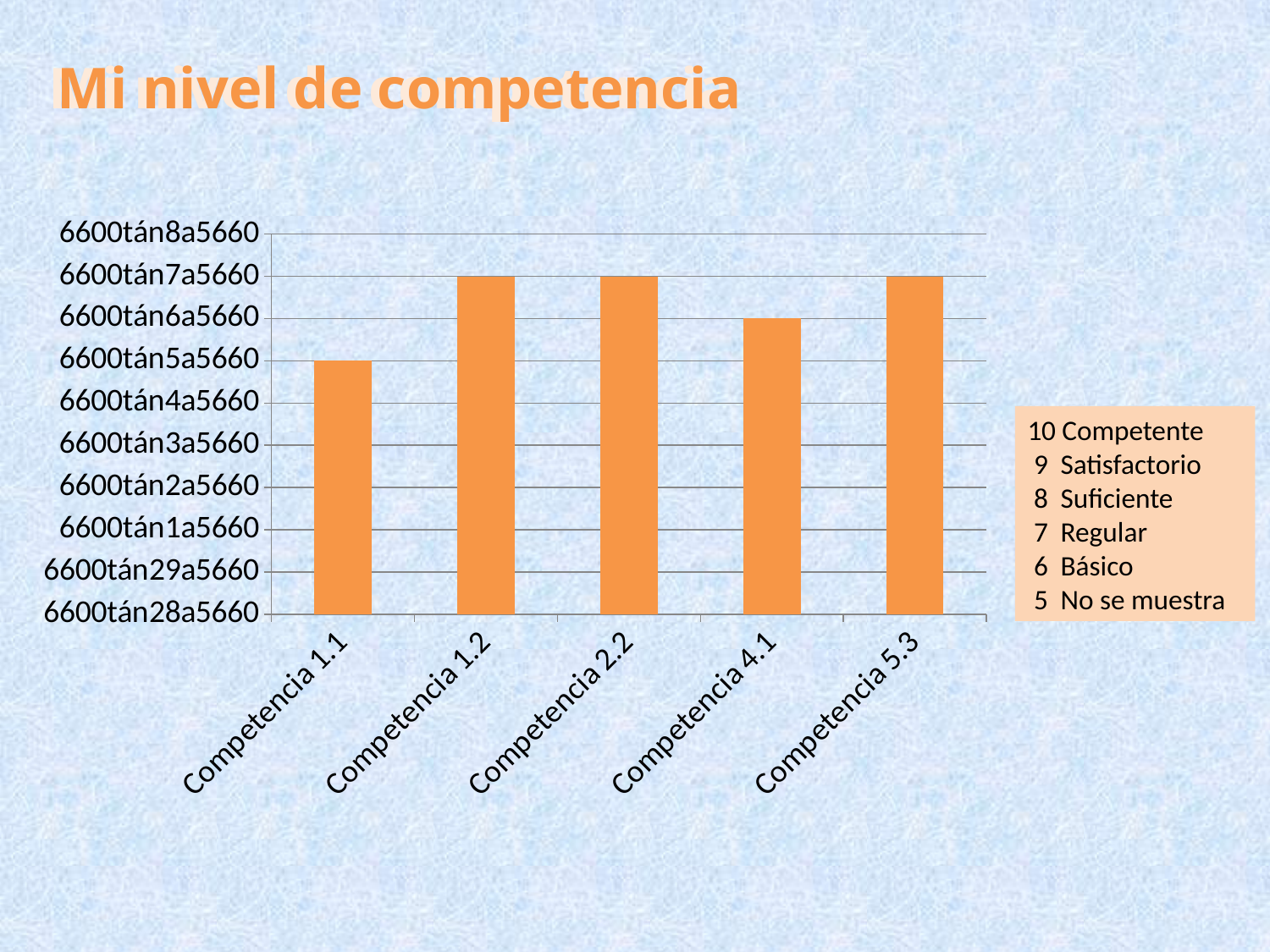
Which competencia has the lowest bar in the chart? Competencia 1.1 What is the title of the slide containing the chart? Mi nivel de competencia What colour are the bars in the chart? Orange Which is larger, the value for Competencia 4.1 or for Competencia 1.1? Competencia 4.1 Which is larger, the value for Competencia 1.2 or for Competencia 1.1? Competencia 1.2 What kind of chart is shown on the slide? Bar chart Which is larger, the value for Competencia 2.2 or for Competencia 4.1? Competencia 2.2 How many competencias (categories) are plotted in the chart? 5